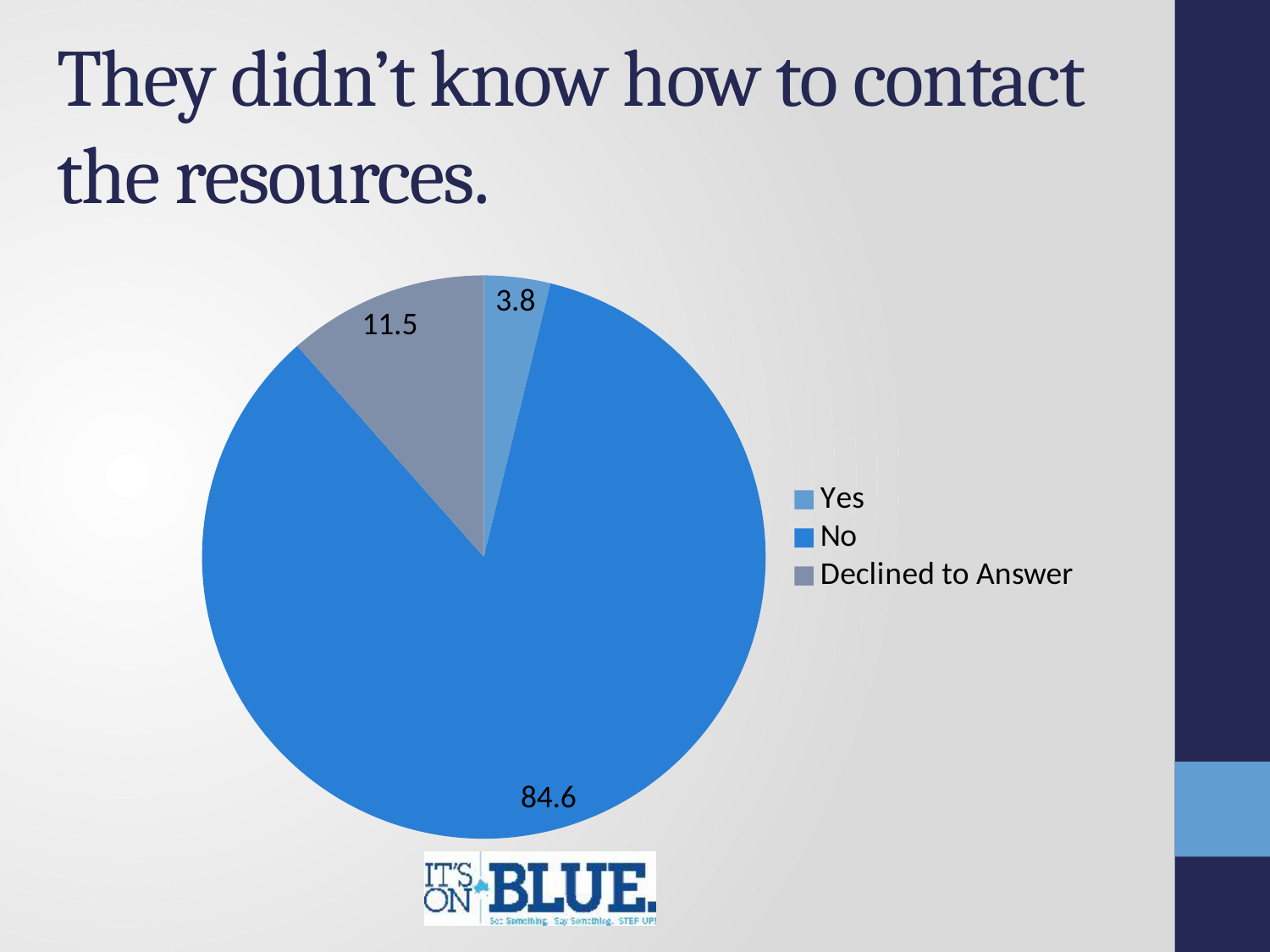
How many slices does the pie chart have? 3 Which category has the largest slice? No What is the title of the slide containing the pie chart? They didn't know how to contact the resources. Which is larger, the value for Yes or the value for Declined to Answer? Declined to Answer What is the difference between the values for Declined to Answer and Yes? 7.7 What is the value for Yes? 3.8 What is the difference between the values for No and Declined to Answer? 73.1 Which category has the smallest slice? Yes What kind of chart is shown on the slide? pie chart What is the value for No? 84.6 What is the value for Declined to Answer? 11.5 How many entries does the legend list? 3